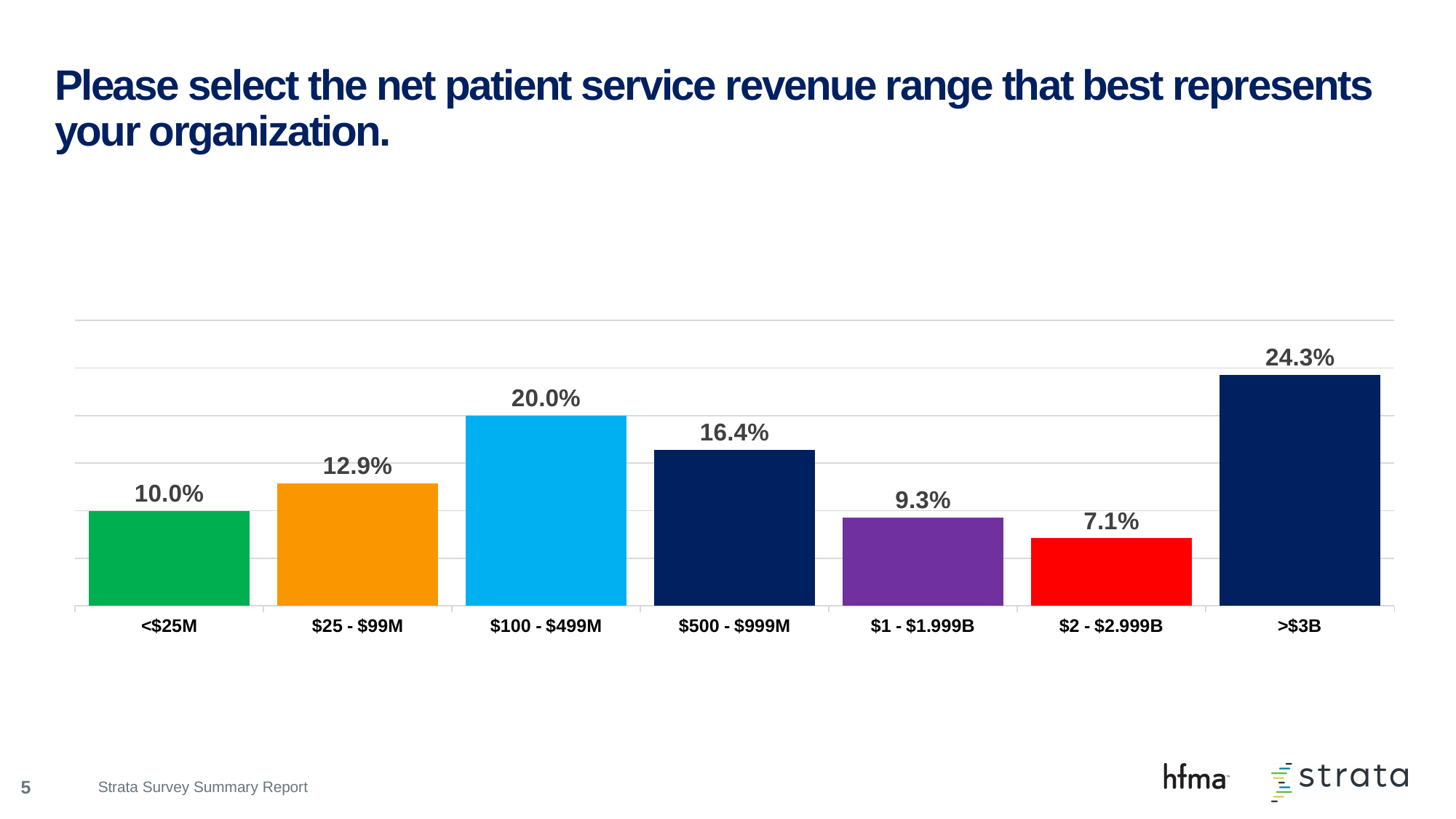
Which revenue range has the highest percentage? >$3B What is the value shown for the $500 - $999M category? 16.4% What is the value shown for the <$25M category? 10.0% What type of chart is shown on the slide? Bar chart What is the difference between the percentages for >$3B and $100 - $499M? 4.3% What is the difference between the values for $500 - $999M and $1 - $1.999B? 7.1% What colour is the bar for the $1 - $1.999B category? Purple Which has a larger value, $25 - $99M or $1 - $1.999B? $25 - $99M What percentage of respondents selected the $100 - $499M net patient service revenue range? 20.0% Which revenue range has the lowest percentage? $2 - $2.999B What percentage is shown for the $2 - $2.999B range? 7.1% How many revenue range categories are shown on the chart? 7